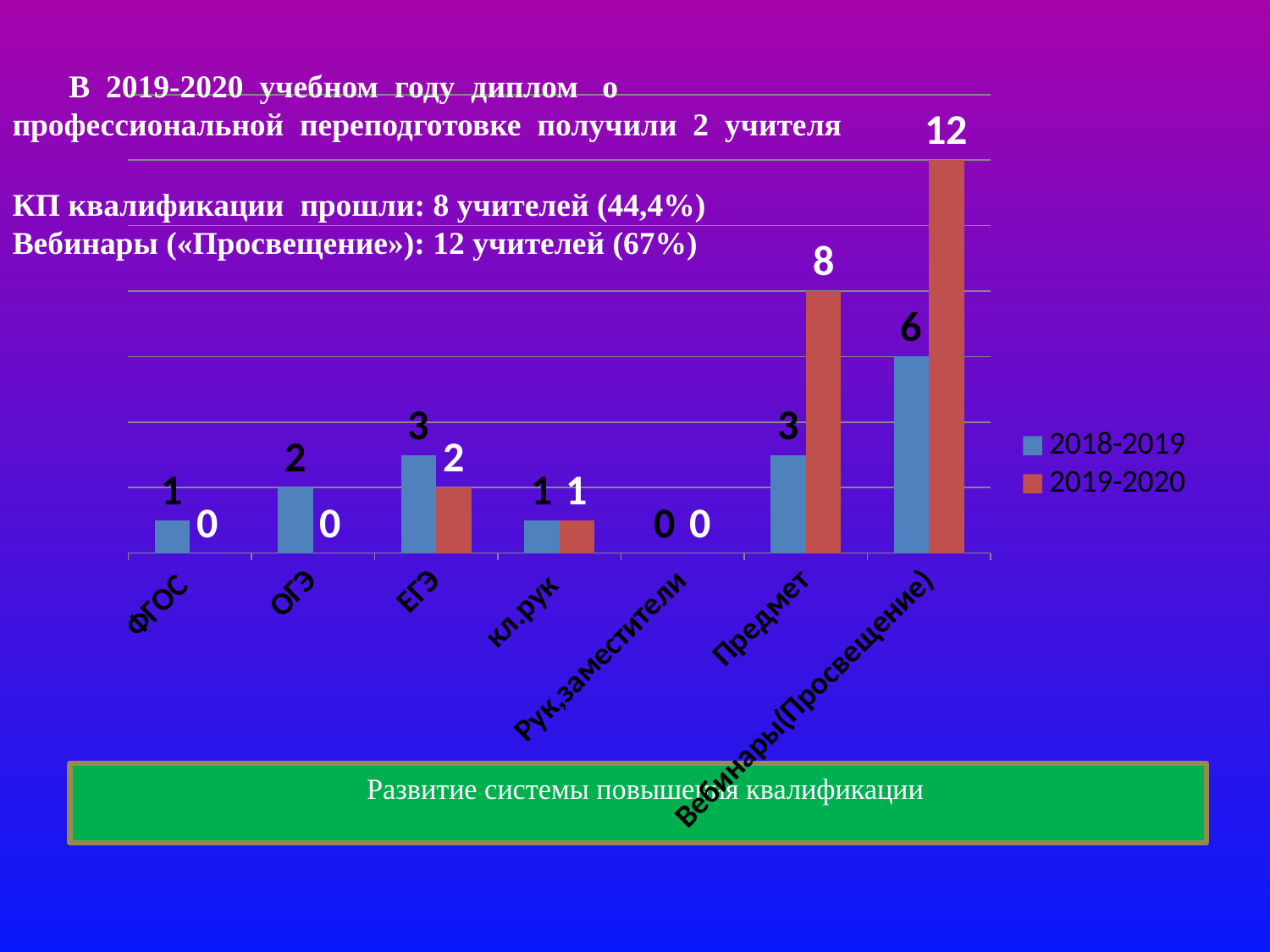
How many categories are shown on the x axis? 7 What is the difference between the 2019-2020 and 2018-2019 values for Предмет? 5 How many series does the legend list? 2 Which series is shown in red in the legend? 2019-2020 What kind of chart is shown on the slide? bar chart Which category has the lowest value in the 2018-2019 series? Рук,заместители What is the value for Предмет in the 2018-2019 series? 3 What is the value for Вебинары(Просвещение) in the 2019-2020 series? 12 Which is larger for ЕГЭ: the 2018-2019 value or the 2019-2020 value? 2018-2019 Which category has the highest value in the 2019-2020 series? Вебинары(Просвещение) What is the difference between the 2019-2020 and 2018-2019 values for Вебинары(Просвещение)? 6 What is the value for ОГЭ in the 2019-2020 series? 0